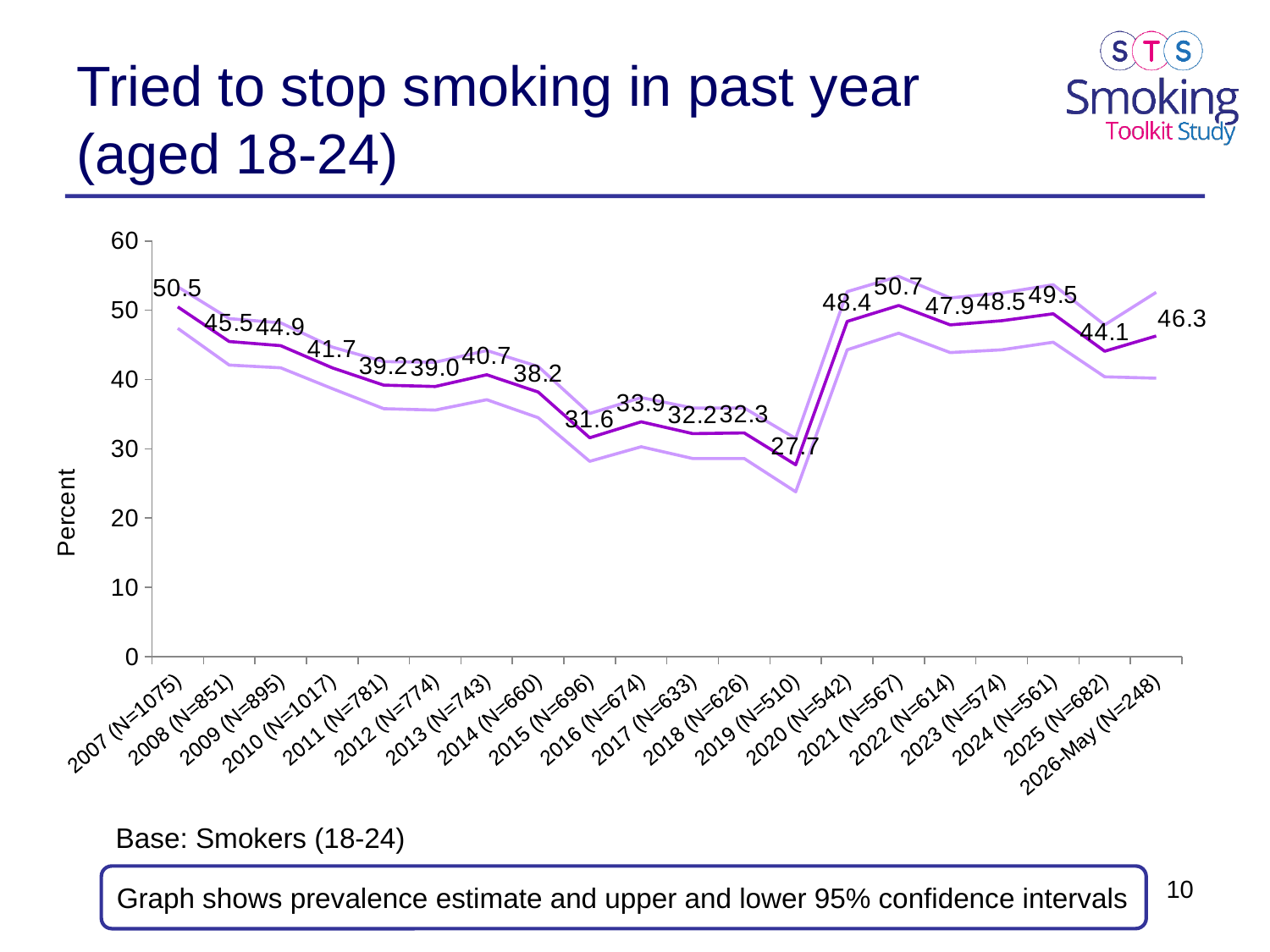
What is the prevalence estimate for 2026-May (N=248)? 46.3 What is the prevalence estimate for 2007 (N=1075)? 50.5 Which is larger, the prevalence estimate for 2015 (N=696) or for 2016 (N=674)? 2016 (N=674) What is the prevalence estimate for 2019 (N=510)? 27.7 Is the prevalence estimate for 2013 (N=743) greater or less than 40? greater What is the difference between the prevalence estimates for 2020 (N=542) and 2019 (N=510)? 20.7 How many time points are plotted on the x axis? 20 Do the prevalence estimates rise or fall from 2007 (N=1075) to 2019 (N=510)? Fall Which year has the lowest prevalence estimate? 2019 (N=510) What kind of chart is shown on the slide? Line chart What is the label on the y axis of the chart? Percent Which year has the highest prevalence estimate? 2021 (N=567)